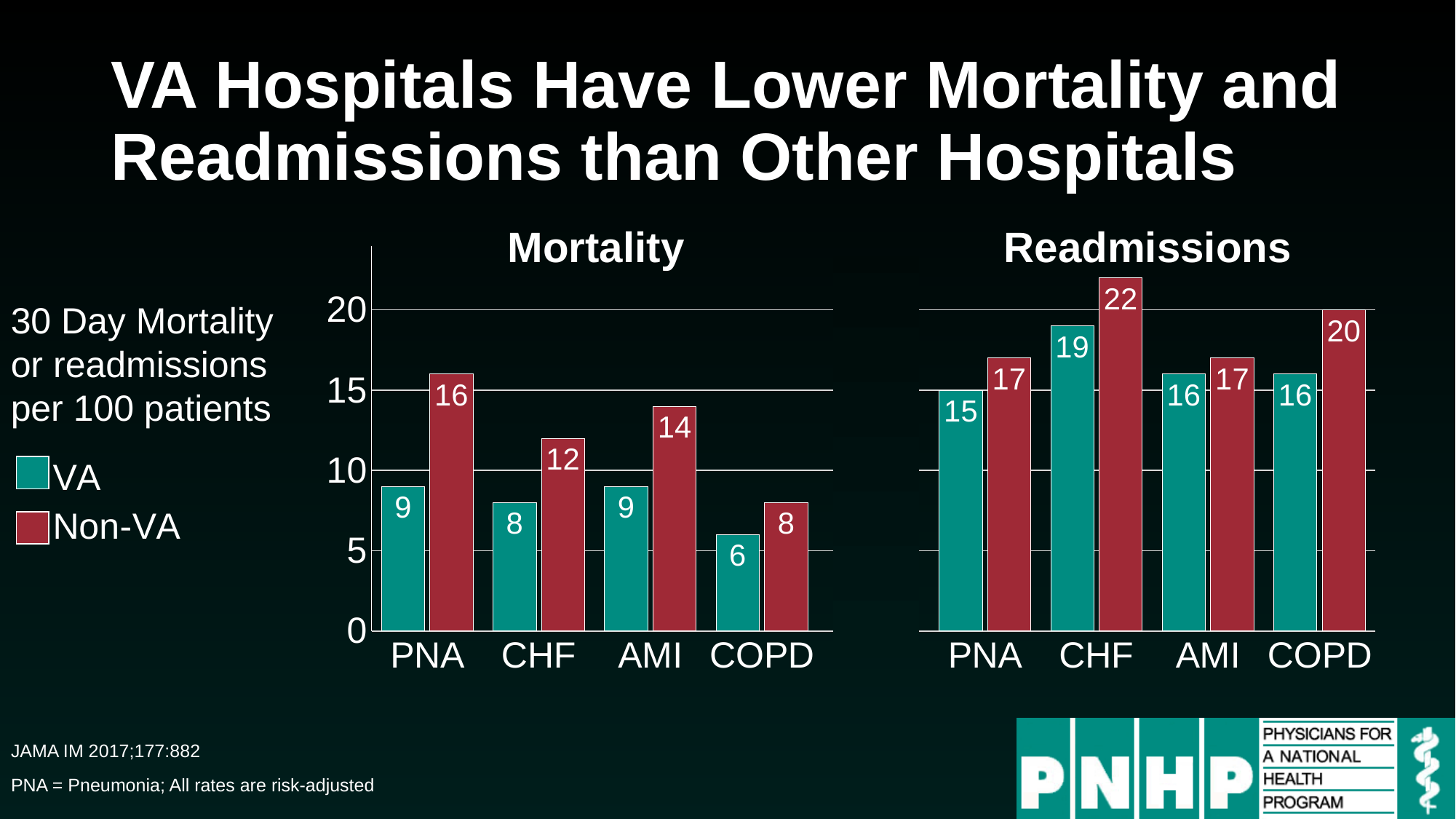
In the Readmissions chart, which category has the highest Non-VA value? CHF How many series does the legend list? 2 In the Mortality chart, what is the difference between the Non-VA and VA values for PNA? 7 In the Mortality chart, which category has the lowest VA value? COPD What kind of chart is the Readmissions chart? bar chart How many categories are shown on the x axis of the Mortality chart? 4 In the Mortality chart, what is the Non-VA value for PNA? 16 In the Readmissions chart, is the Non-VA value for CHF greater or less than 20? greater In the Mortality chart, which is larger for AMI, the VA value or the Non-VA value? Non-VA In the Readmissions chart, what is the VA value for CHF? 19 In the Readmissions chart, what is the difference between the Non-VA and VA values for COPD? 4 In the Mortality chart, what is the VA value for COPD? 6